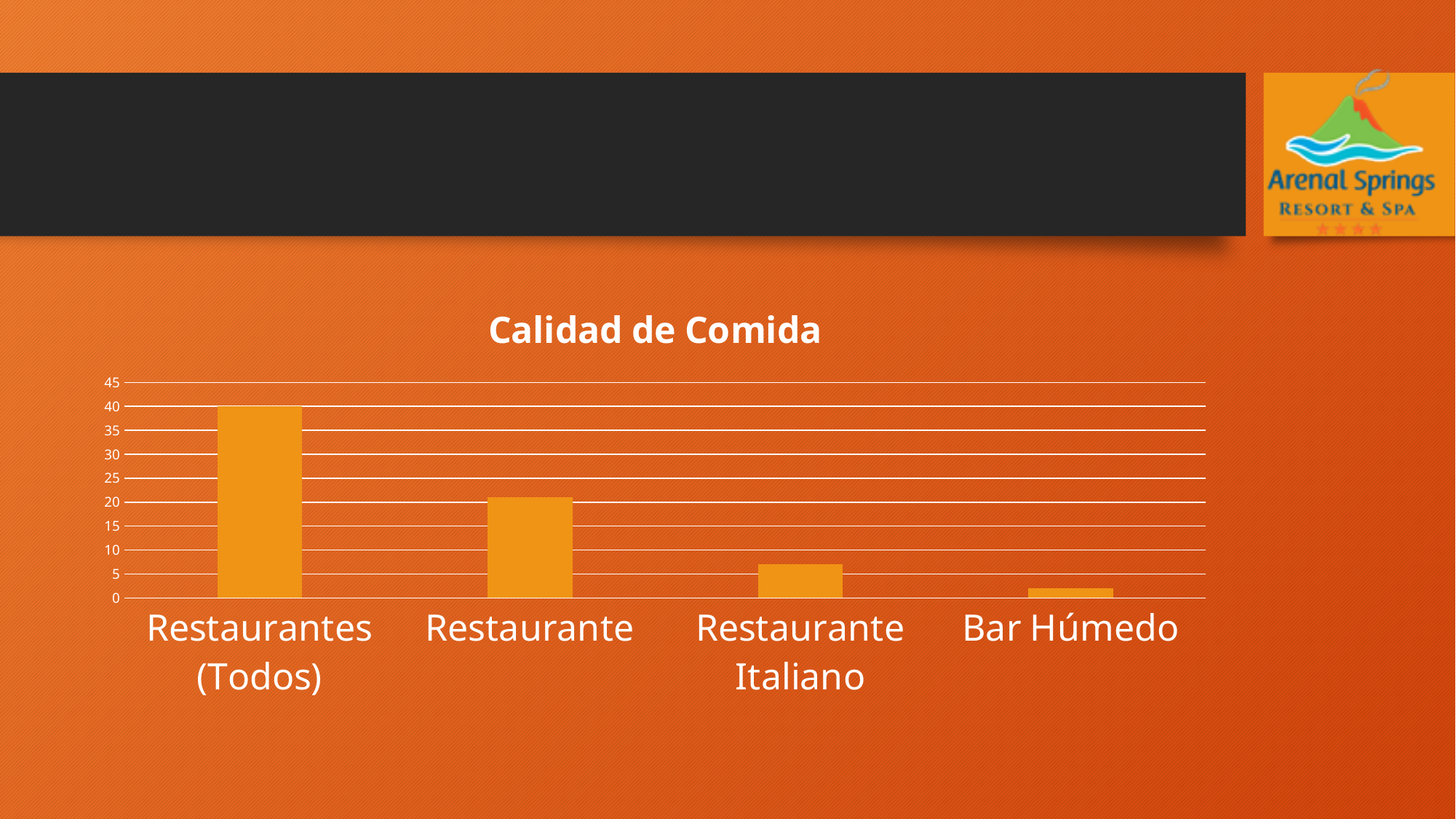
What is the title of the chart? Calidad de Comida Which is larger, the value for Restaurante or the value for Restaurante Italiano? Restaurante Which category has the lowest value in the chart? Bar Húmedo Which category has the highest value in the chart? Restaurantes (Todos) How many categories are shown on the x axis of the chart? 4 Is the value for Restaurante greater or less than 15? greater What is the value for Restaurantes (Todos)? 40 Is the value for Restaurante greater or less than 25? less Is the value for Bar Húmedo greater or less than 5? less What kind of chart is shown on the slide? bar chart Do the values rise or fall from left to right along the x axis? fall